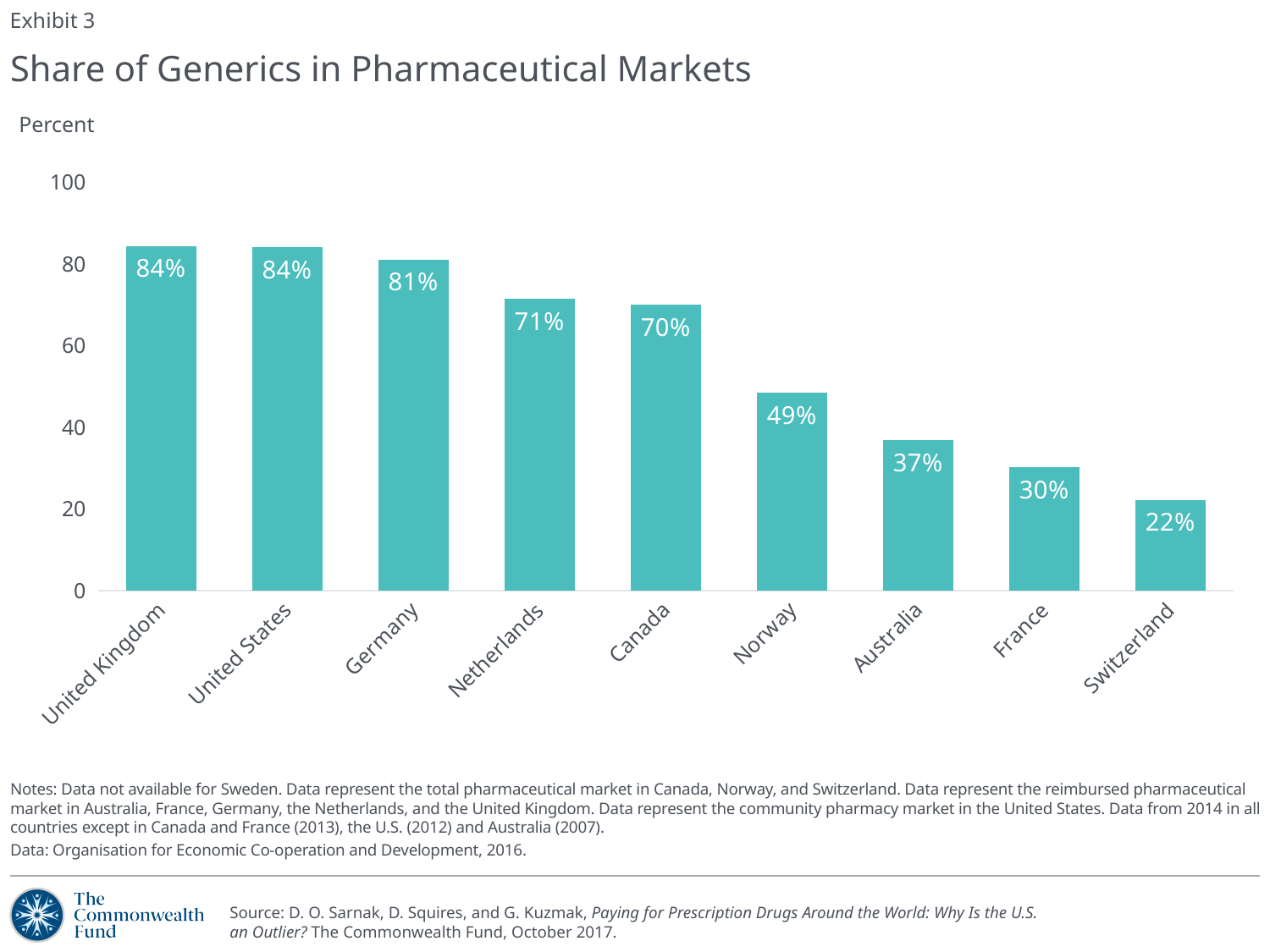
What is the value shown for Norway? 49% Is the value for Australia greater or less than 40? less How many countries are shown in the chart? 9 What is the difference between the values for Germany and France? 51 percentage points What is the difference between the values for the Netherlands and Australia? 34 percentage points Which is larger, the value for Canada or the value for Norway? Canada What is the share of generics in the pharmaceutical market for Germany? 81% What is the title of the chart? Share of Generics in Pharmaceutical Markets What kind of chart is shown on the slide? Bar chart Do the values rise or fall from left to right across the countries? Fall Which country has the lowest share of generics? Switzerland What is the value shown for Switzerland? 22%